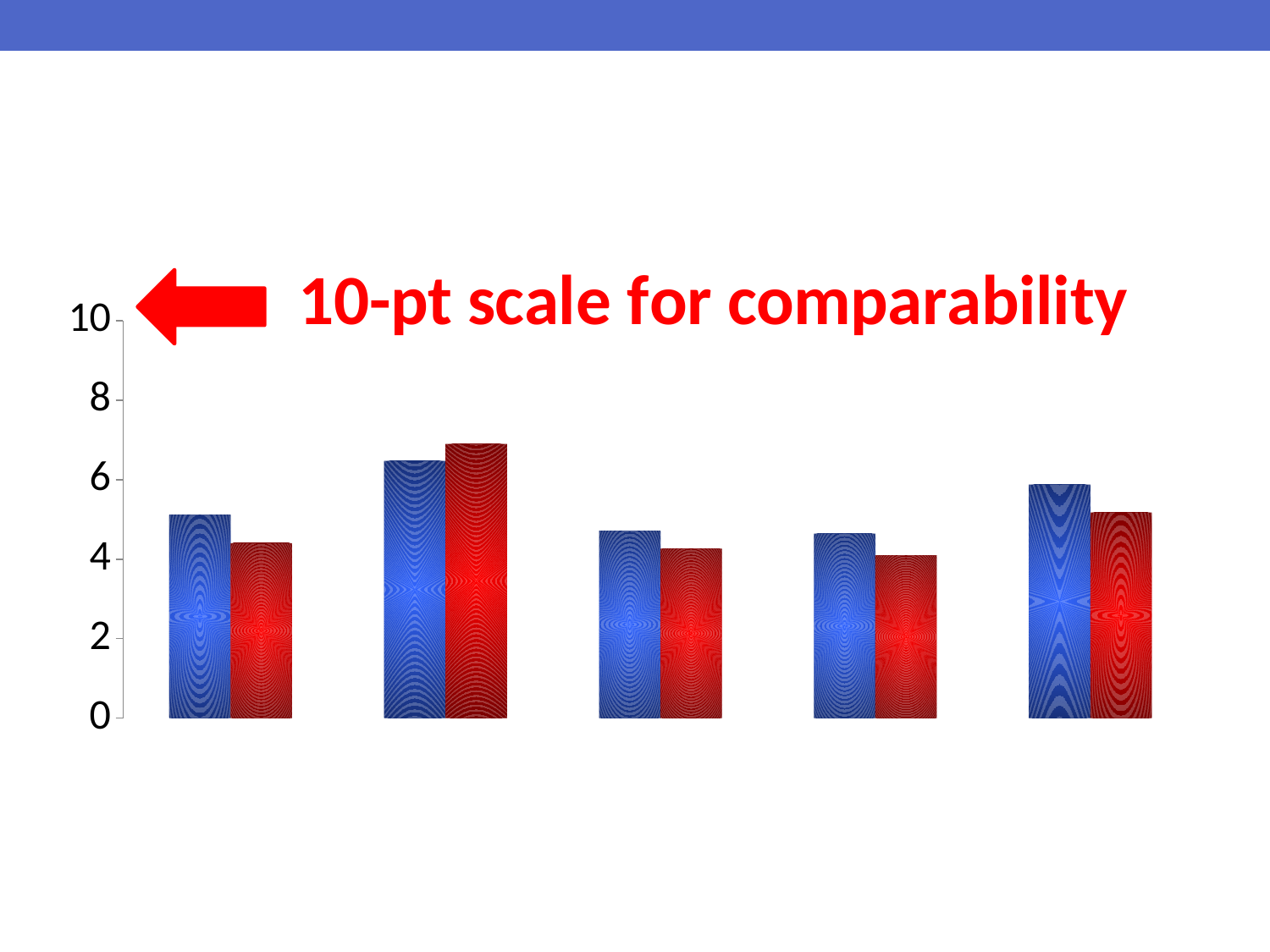
How many differently coloured bar series does the chart show? 2 In the first group of bars from the left, is the blue bar or the red bar taller? the blue bar What does the red annotation text next to the arrow at the top of the chart say? 10-pt scale for comparability Is the value of the blue bar in the first group from the left greater or less than 4? greater How many groups of bars are plotted in the chart? 5 Is the value of the blue bar in the second group from the left greater or less than 6? greater How many bars in total are plotted in the chart? 10 Is the value of the red bar in the fourth group from the left greater or less than 6? less What is the highest value shown on the vertical axis of the chart? 10 Which group of bars, counting from the left, contains the tallest bar in the chart? the second group What kind of chart is shown on the slide? bar chart In the second group of bars from the left, is the blue bar or the red bar taller? the red bar